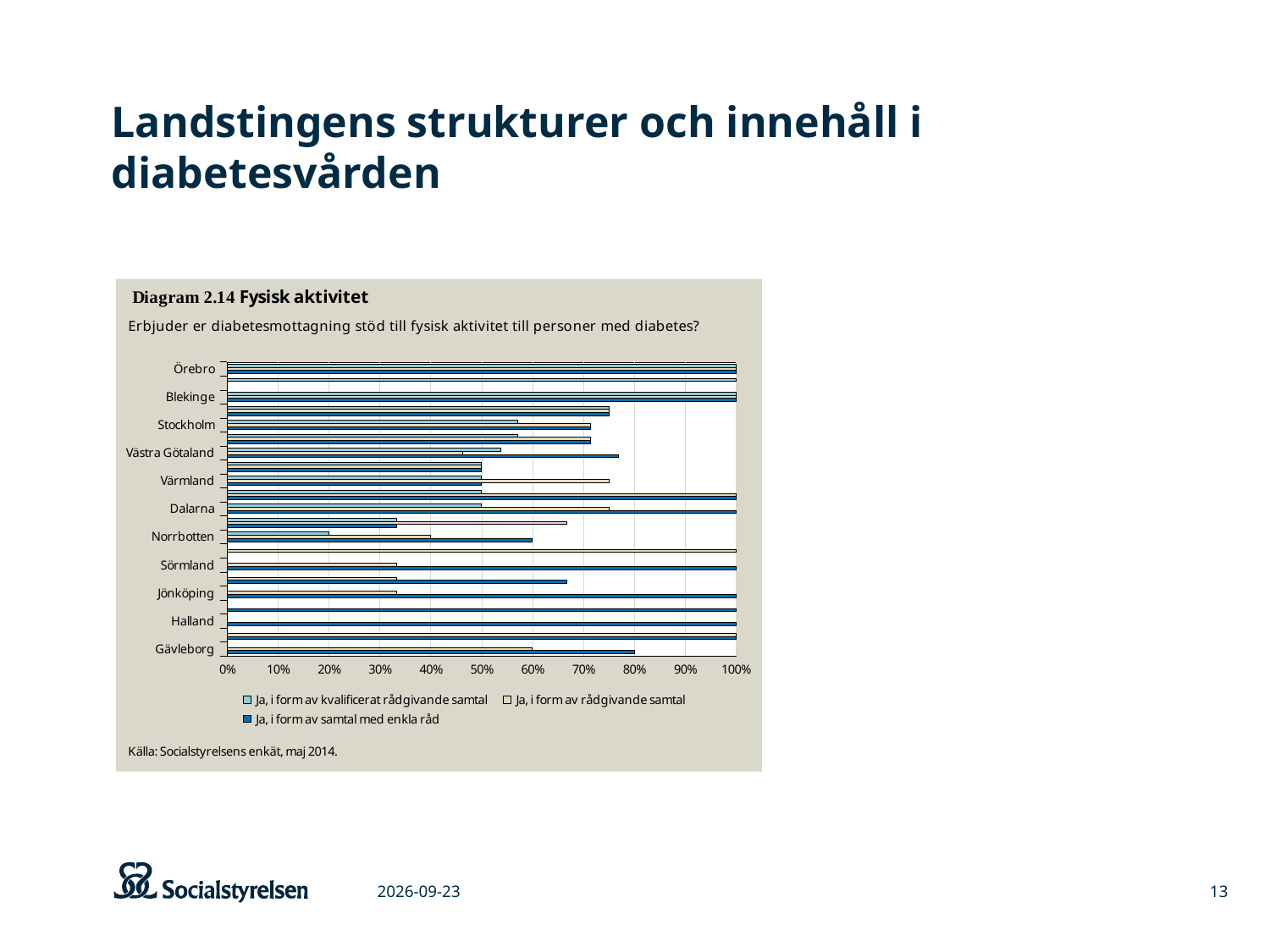
Which region is listed at the top of the chart's y axis? Örebro What is the title of the diagram on the slide? Diagram 2.14 Fysisk aktivitet What value do the bars for Örebro reach on the x axis? 100% Which legend entry is shown with the dark blue colour? Ja, i form av samtal med enkla råd Are the values for Örebro greater or less than 90%? greater Which region is listed at the bottom of the chart's y axis? Gävleborg What is the maximum value shown on the x axis of the chart? 100% How many series does the legend of Diagram 2.14 list? 3 Are the values for Norrbotten greater or less than 70%? less What type of chart is shown in Diagram 2.14? bar chart